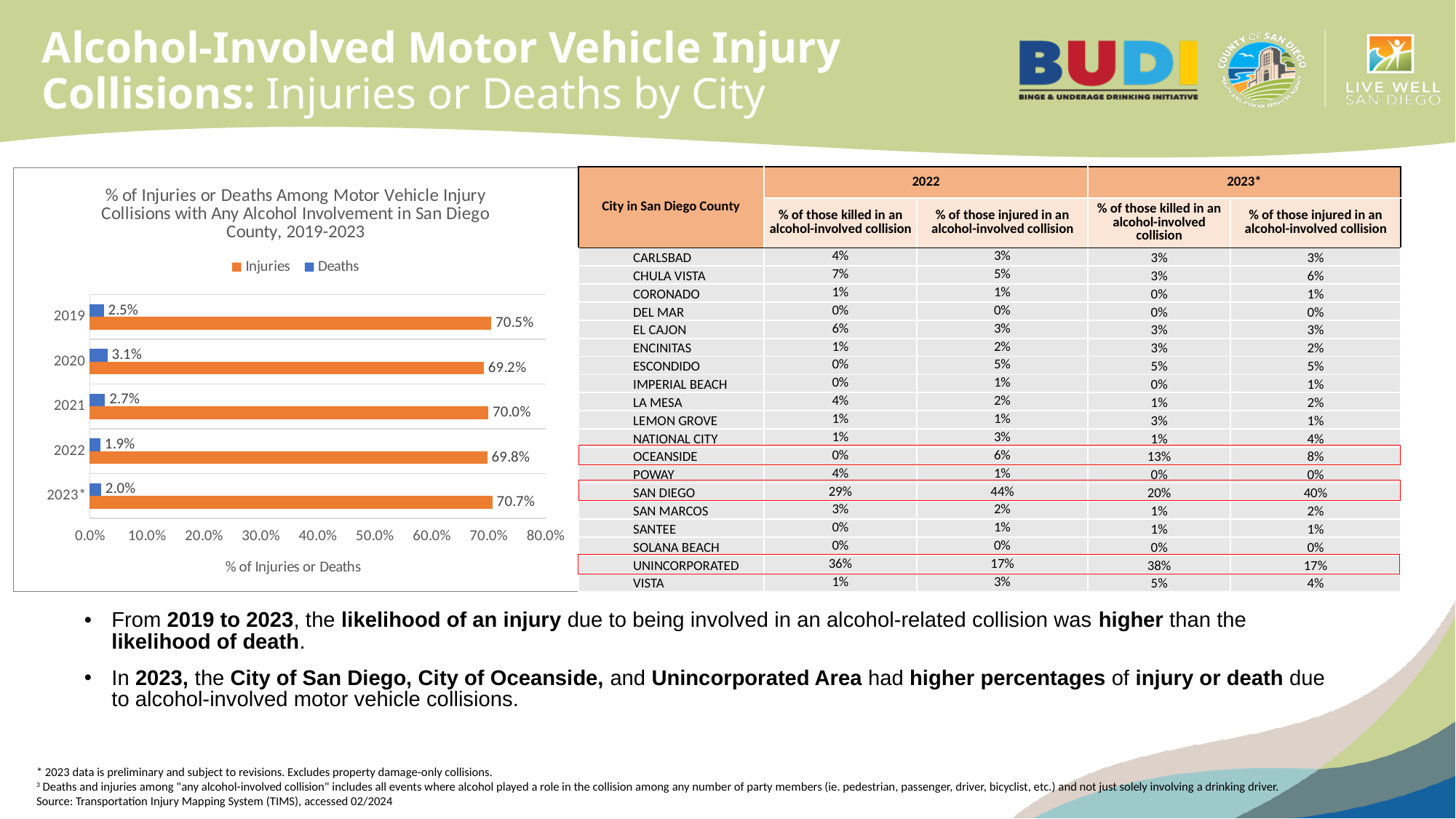
What is the Injuries value for 2019 on the chart? 70.5% What is the Injuries value for 2023* on the chart? 70.7% Which year has the lowest Deaths value on the chart? 2022 Which colour represents the Injuries series in the chart? Orange How many years are plotted on the chart? 5 What is the difference between the Injuries and Deaths values for 2019 on the chart? 68.0 percentage points Is the Injuries value for 2021 greater or less than 60.0%? greater Which year has the highest Deaths value on the chart? 2020 What type of chart is shown on the left of the slide? Bar chart How many series does the chart legend list? 2 Which year has the lowest Injuries value on the chart? 2020 What is the Deaths value for 2020 on the chart? 3.1%